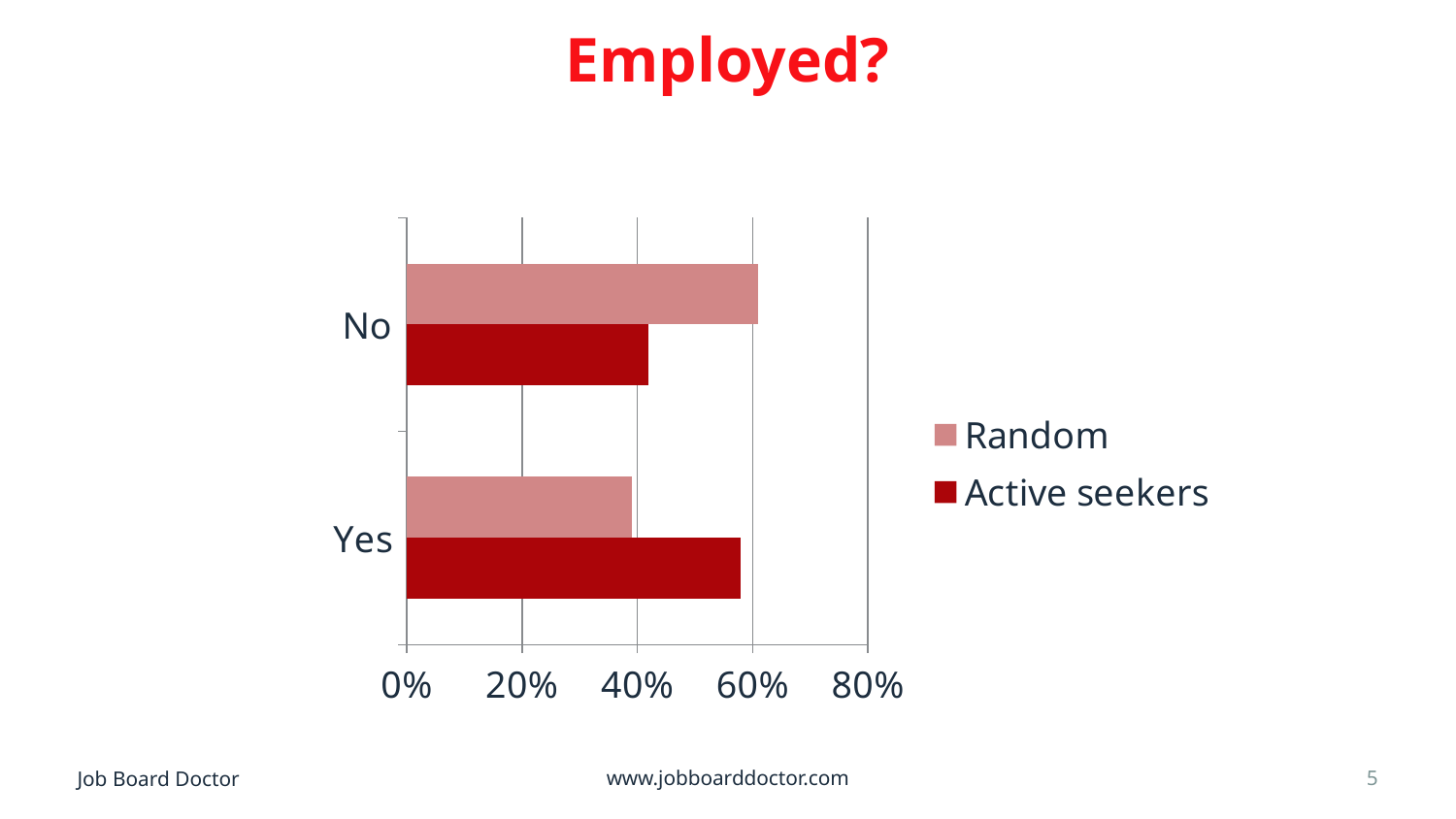
Is the Active seekers value for No greater or less than 60%? less For the Random series, which category has the higher value, No or Yes? No What kind of chart is shown on the slide? bar chart For the Yes category, which series has the larger value, Random or Active seekers? Active seekers What is the title of the chart? Employed? How many categories are shown on the chart? 2 Which series is shown in dark red? Active seekers How many series does the legend list? 2 For the Active seekers series, which category has the higher value, No or Yes? Yes Is the Active seekers value for Yes greater or less than 40%? greater Is the Random value for No greater or less than 40%? greater